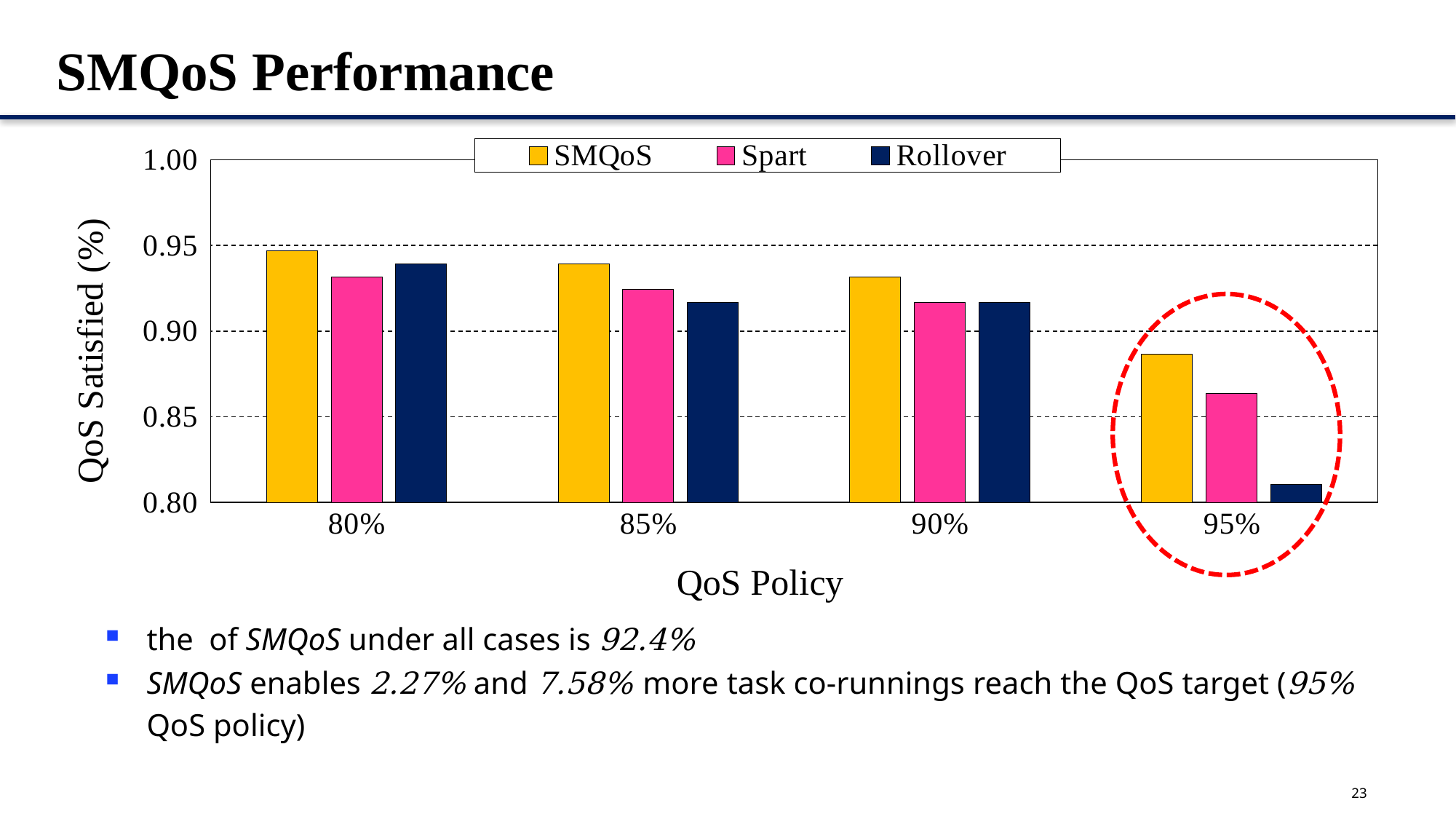
What kind of chart is shown on the slide? bar chart Is the value for Rollover at the 85% QoS policy greater or less than 0.90? greater How many series does the legend list? 3 How many QoS policy categories are shown on the x axis? 4 What is the title of the y axis? QoS Satisfied (%) Is the value for Spart at the 80% QoS policy greater or less than 0.90? greater At which QoS policy is the SMQoS bar highest? 80% Do the SMQoS values rise or fall as the QoS policy increases from 80% to 95%? fall Is the value for SMQoS at the 95% QoS policy greater or less than 0.90? less At the 95% QoS policy, which is larger: SMQoS or Rollover? SMQoS At which QoS policy is the Rollover bar lowest? 95%